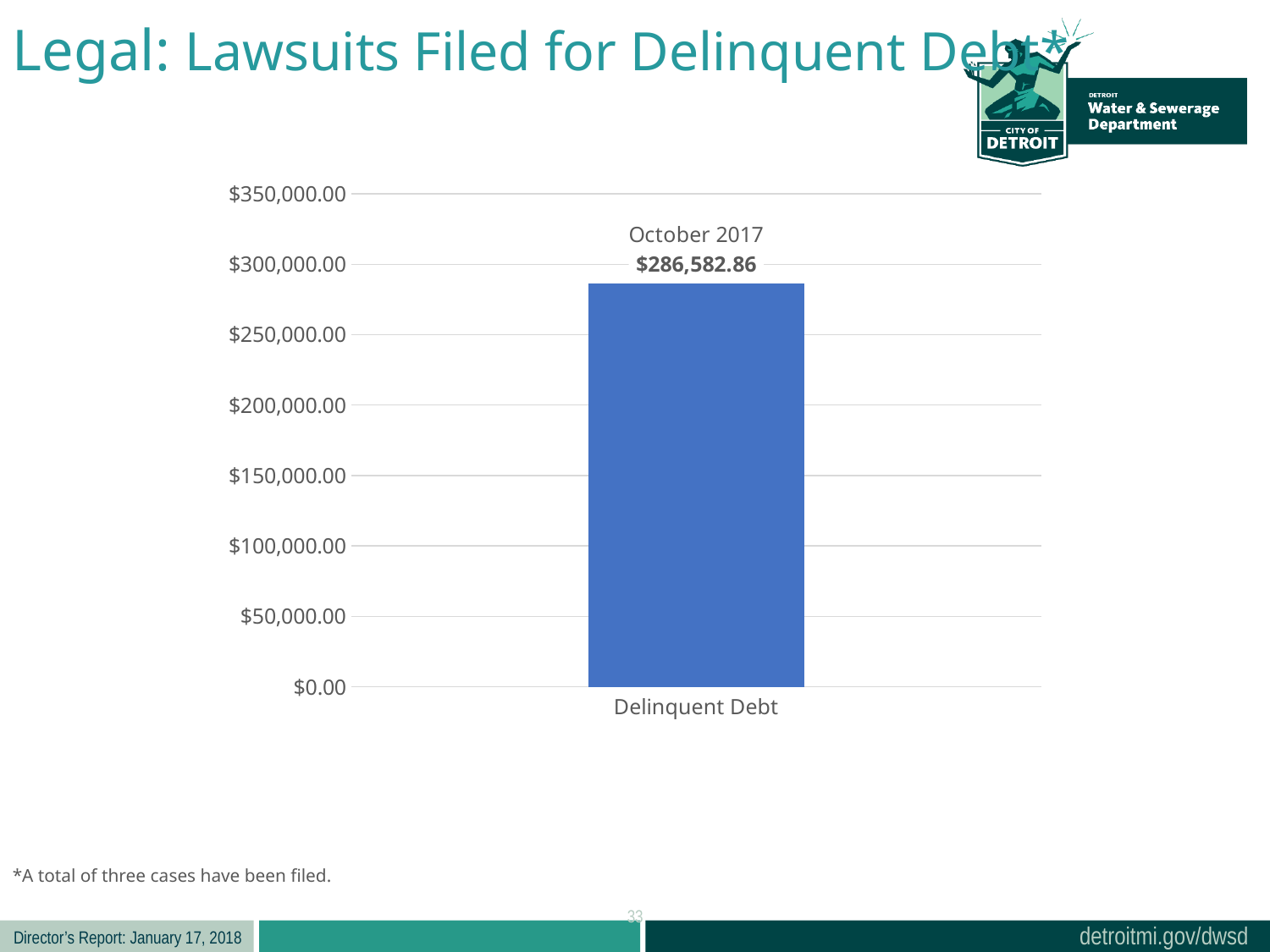
What kind of chart is shown on the slide? bar chart What is the value of the Delinquent Debt bar? $286,582.86 Is the value for Delinquent Debt greater or less than $250,000.00? greater How many bars does the chart show? 1 Is the value for Delinquent Debt greater or less than $300,000.00? less What is the category label shown on the x axis? Delinquent Debt What is the highest value shown on the y axis? $350,000.00 Which month is labelled above the bar? October 2017